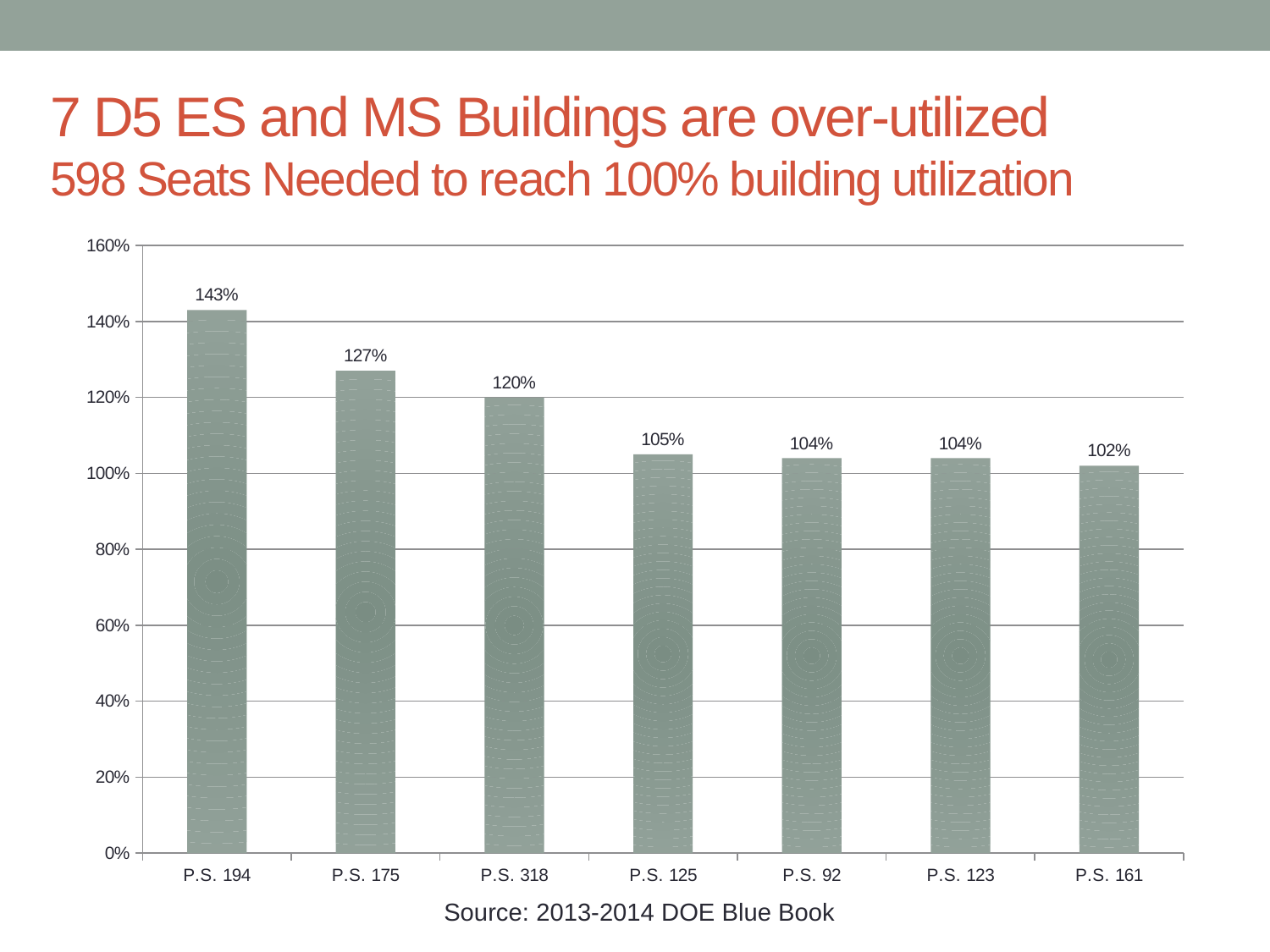
Which building has the lowest utilization? P.S. 161 What is the utilization value for P.S. 161? 102% Which building has the highest utilization? P.S. 194 What is the source cited below the chart? 2013-2014 DOE Blue Book Is the value for P.S. 92 greater or less than 120%? less What kind of chart is shown on the slide? bar chart How many buildings are shown in the chart? 7 What is the utilization value for P.S. 318? 120% What is the difference between the utilization of P.S. 318 and P.S. 125? 15% What is the difference between the utilization of P.S. 194 and P.S. 175? 16% Which has a higher utilization, P.S. 175 or P.S. 125? P.S. 175 What is the utilization value for P.S. 194? 143%